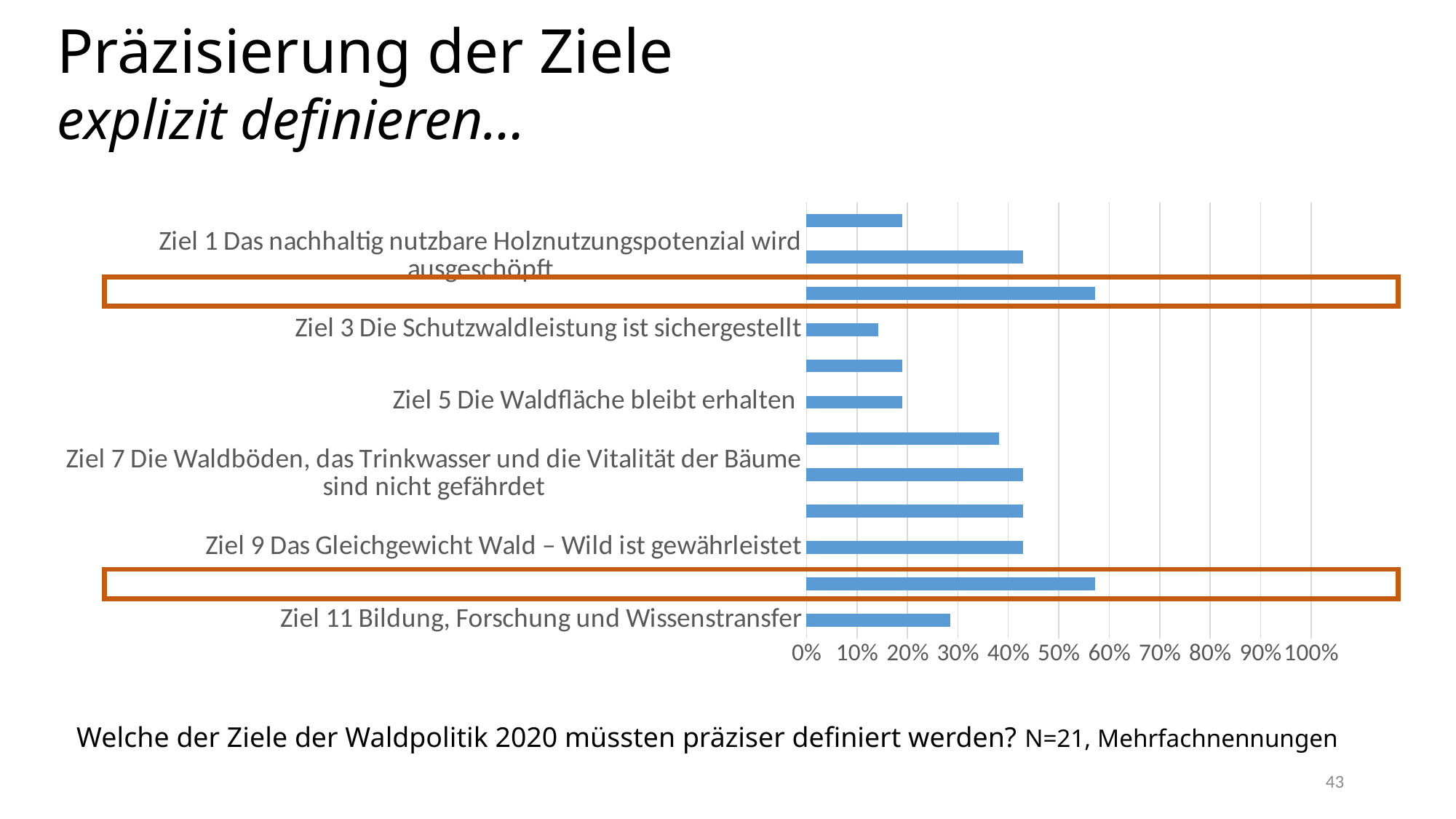
How many category labels are printed on the vertical axis of the chart? 6 How many bars in the chart are highlighted with orange boxes? 2 Are the two bars enclosed in orange boxes greater or less than 50%? greater Is the value for "Ziel 9 Das Gleichgewicht Wald – Wild ist gewährleistet" greater or less than 50%? less Is the value for "Ziel 5 Die Waldfläche bleibt erhalten" greater or less than 30%? less Which has the larger value, "Ziel 9 Das Gleichgewicht Wald – Wild ist gewährleistet" or "Ziel 5 Die Waldfläche bleibt erhalten"? Ziel 9 Das Gleichgewicht Wald – Wild ist gewährleistet What is the highest value shown on the horizontal axis of the chart? 100% How many bars are plotted in the chart? 12 What kind of chart is shown on the slide? bar chart